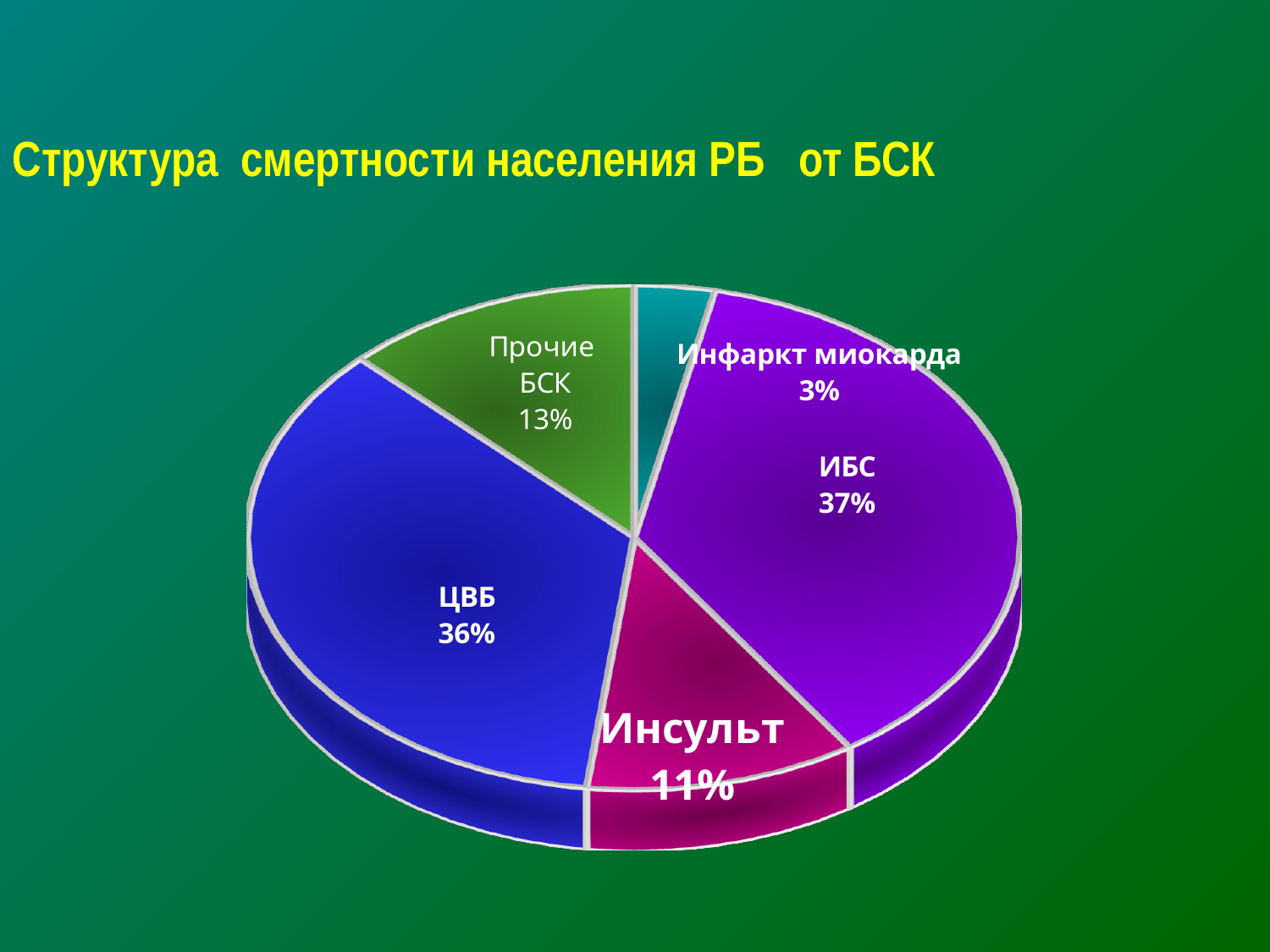
What percentage is shown for Инфаркт миокарда? 3% Which slice of the pie is the largest? ИБС What kind of chart is shown on the slide? Pie chart What share of the pie does ЦВБ account for? 36% What percentage is shown for Прочие БСК? 13% Which slice of the pie is the smallest? Инфаркт миокарда How many slices does the pie chart have? 5 What is the title of the chart on the slide? Структура смертности населения РБ от БСК What is the difference in percentage points between ИБС and Инсульт? 26 What percentage is shown for Инсульт? 11% What share of the pie does ИБС account for? 37% Which is larger, the share for Прочие БСК or the share for Инсульт? Прочие БСК